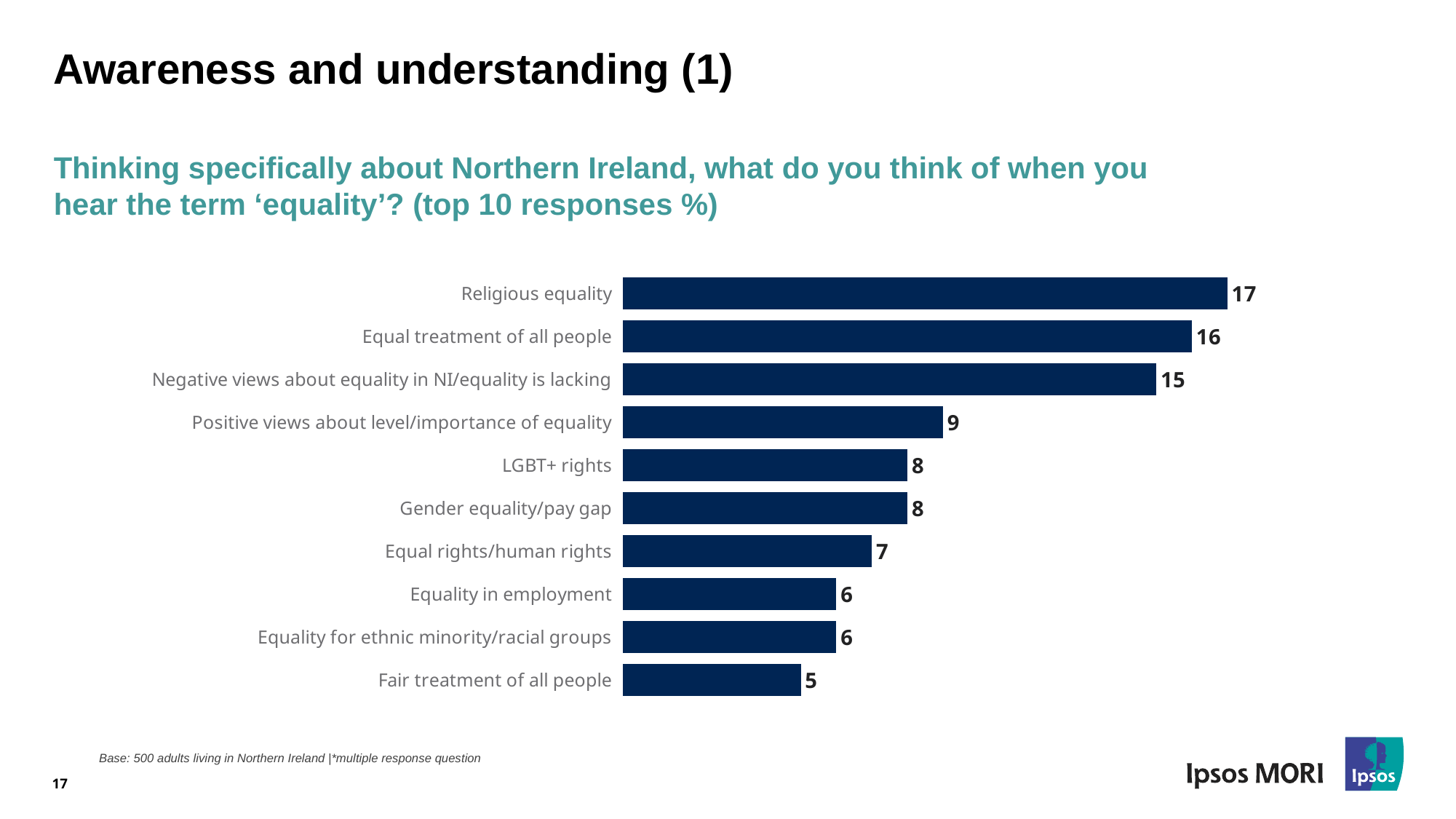
What kind of chart is shown on the slide? Bar chart Which is larger, the value for Negative views about equality in NI/equality is lacking or the value for Equal rights/human rights? Negative views about equality in NI/equality is lacking What is the value for Gender equality/pay gap? 8 What is the value for Religious equality? 17 Which category has the lowest value? Fair treatment of all people What is the value for Positive views about level/importance of equality? 9 How many categories are shown in the chart? 10 What is the value for Equality in employment? 6 Which category has the highest value? Religious equality Do the values rise or fall going from the top bar to the bottom bar? Fall What is the difference between the values for Equal treatment of all people and LGBT+ rights? 8 What is the difference between the values for Religious equality and Fair treatment of all people? 12